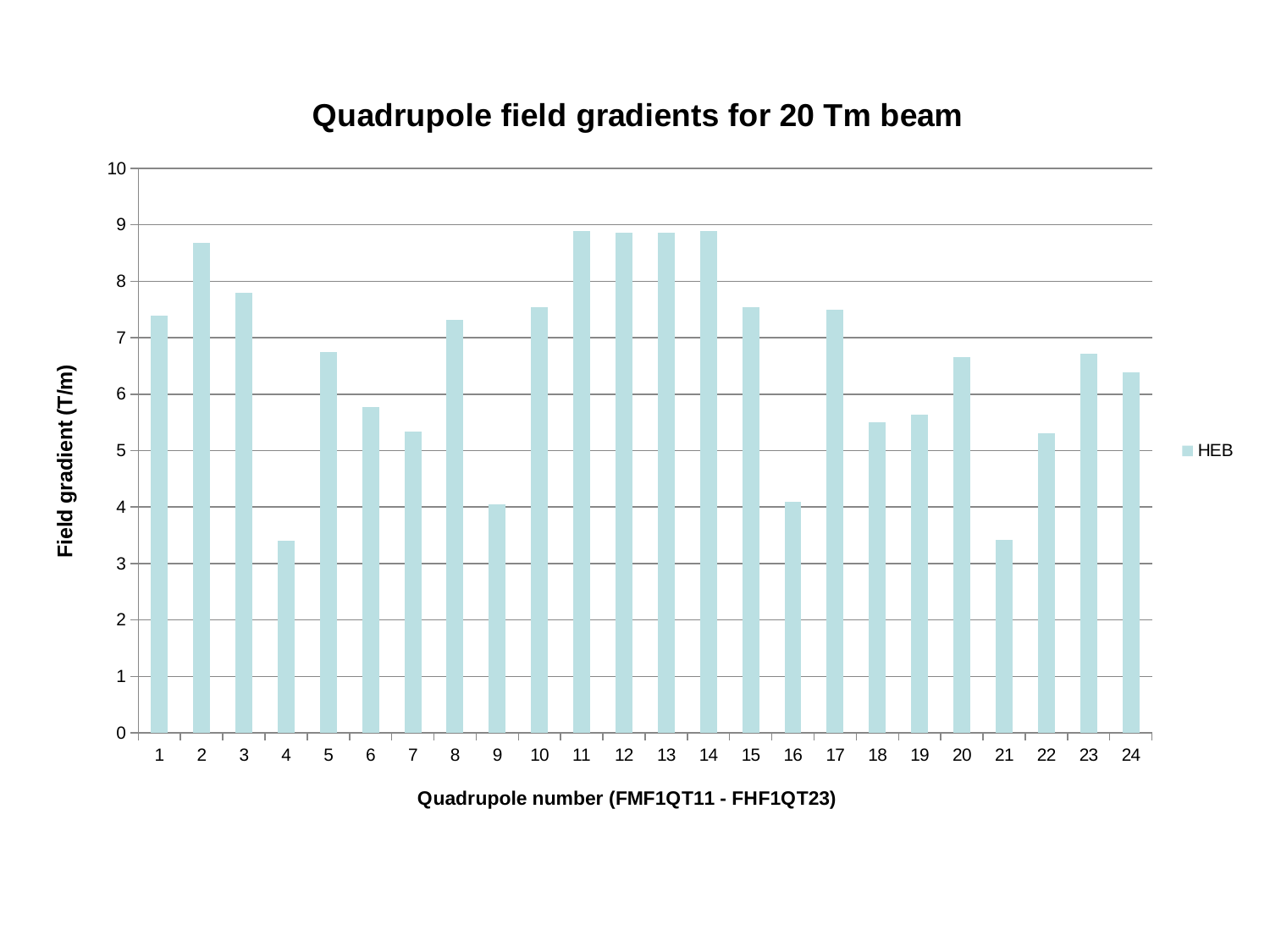
Is the field gradient for quadrupole 2 greater or less than 8? greater How many series does the legend list? 1 What series name appears in the legend? HEB Which has the larger field gradient, quadrupole 2 or quadrupole 4? quadrupole 2 Is the field gradient for quadrupole 4 greater or less than 4? less Which has the larger field gradient, quadrupole 11 or quadrupole 16? quadrupole 11 What is the title of the chart? Quadrupole field gradients for 20 Tm beam Which has the larger field gradient, quadrupole 20 or quadrupole 21? quadrupole 20 How many quadrupoles are plotted on the x axis? 24 Is the field gradient for quadrupole 21 greater or less than 4? less What kind of chart is shown on the slide? bar chart